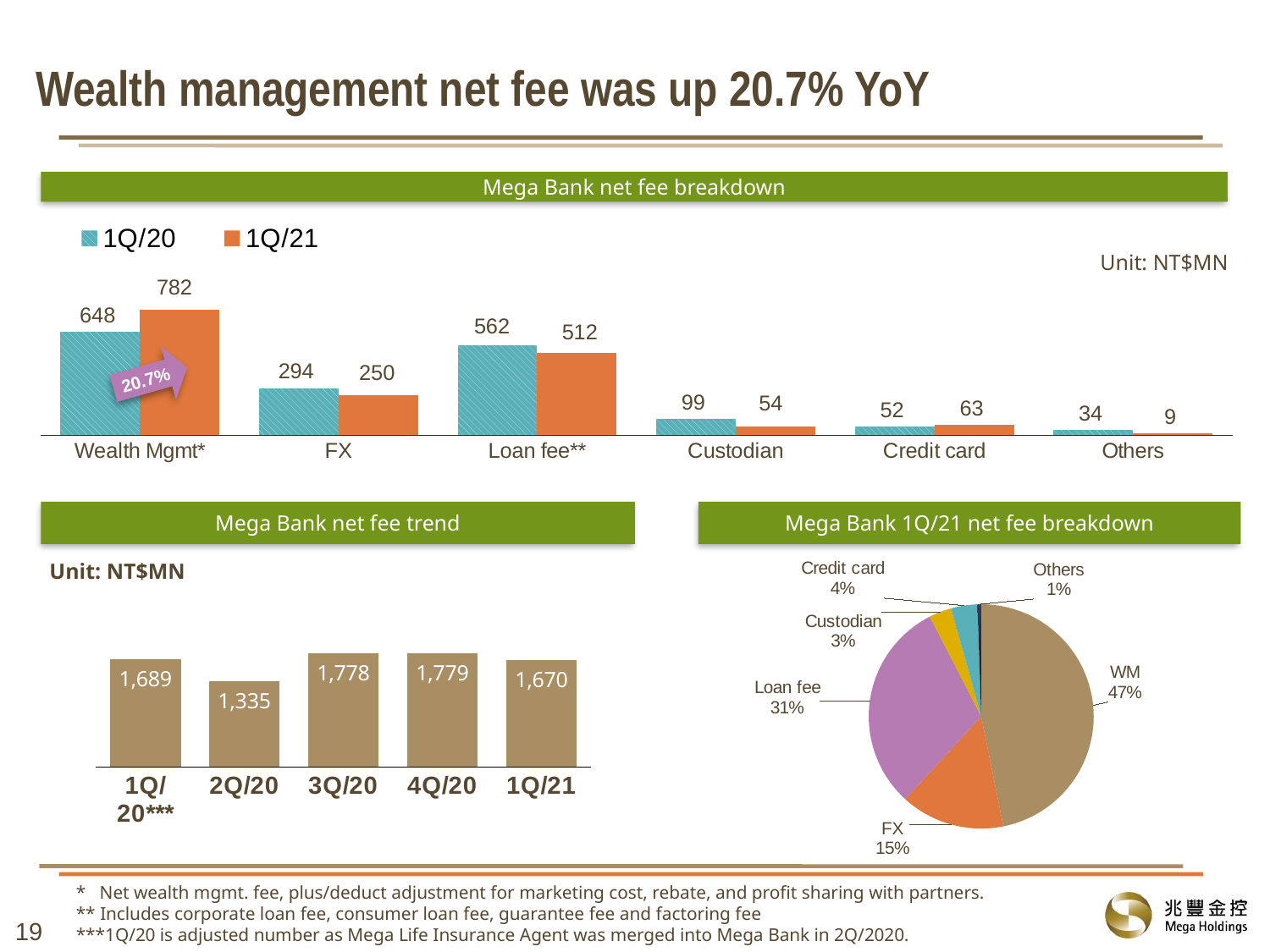
In the 'Mega Bank net fee trend' chart, which quarter has the lowest value? 2Q/20 In the 'Mega Bank net fee breakdown' chart, what is the 1Q/21 value for Wealth Mgmt*? 782 In the 'Mega Bank net fee trend' chart, what is the value for 3Q/20? 1,778 In the 'Mega Bank net fee breakdown' chart, what is the 1Q/20 value for Loan fee**? 562 In the 'Mega Bank net fee breakdown' chart, is the 1Q/20 or the 1Q/21 value larger for Custodian? 1Q/20 In the 'Mega Bank net fee trend' chart, what is the difference between the 4Q/20 and 1Q/21 values? 109 In the 'Mega Bank net fee breakdown' chart, which category has the lowest 1Q/21 value? Others In the 'Mega Bank net fee breakdown' chart, how many categories are shown on the x axis? 6 What type of chart is the 'Mega Bank 1Q/21 net fee breakdown' chart? Pie chart In the 'Mega Bank net fee breakdown' chart, how many series does the legend list? 2 In the 'Mega Bank net fee breakdown' chart, what is the difference between the 1Q/20 and 1Q/21 values for FX? 44 In the 'Mega Bank 1Q/21 net fee breakdown' pie chart, what share does Loan fee have? 31%